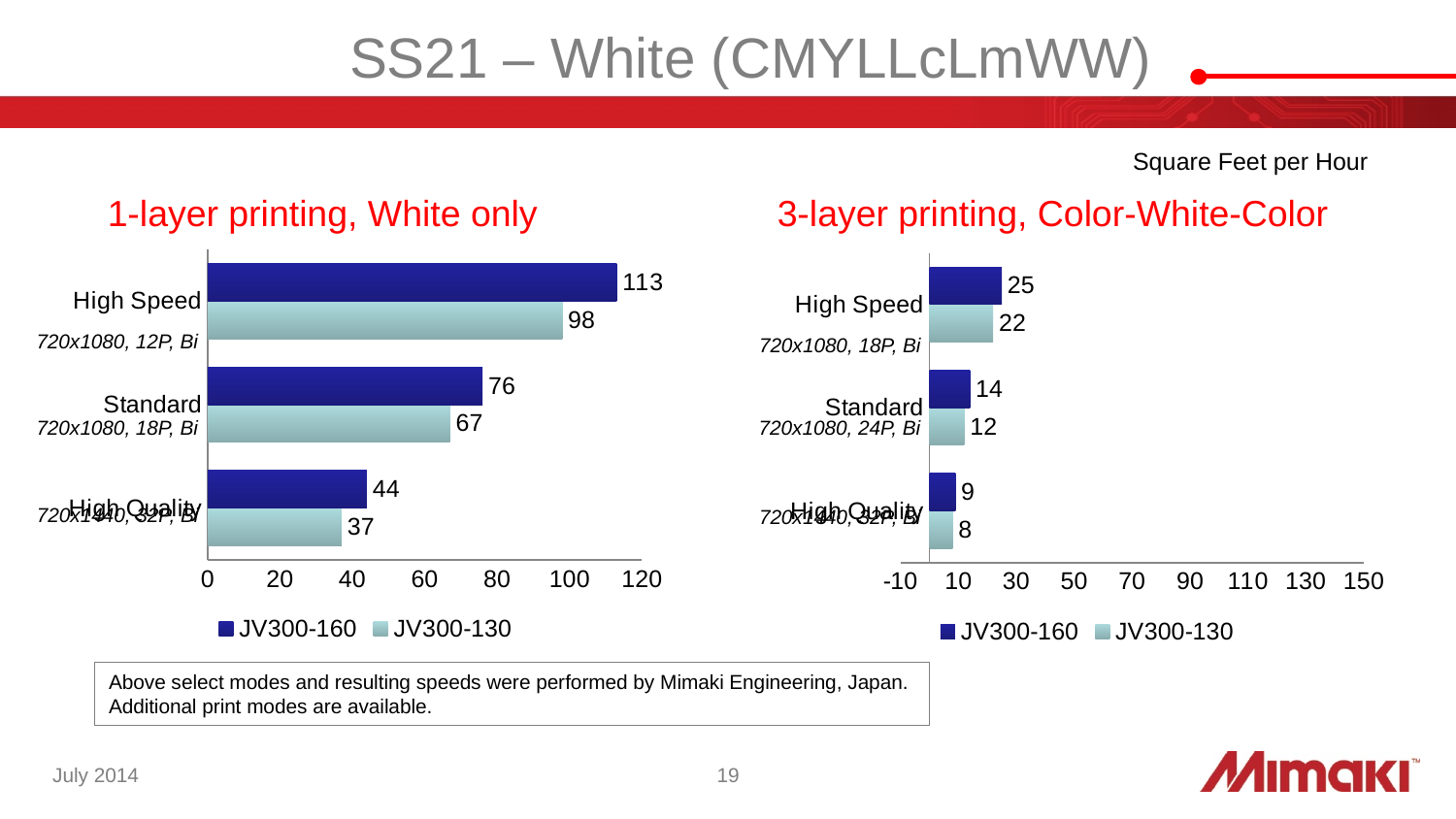
What kind of chart is the '1-layer printing, White only' chart? Bar chart In the '1-layer printing, White only' chart, what is the value for JV300-130 at Standard? 67 In the '3-layer printing, Color-White-Color' chart, what is the value for JV300-130 at High Quality? 8 In the '3-layer printing, Color-White-Color' chart, what is the value for JV300-160 at Standard? 14 In the '3-layer printing, Color-White-Color' chart, which category has the lowest JV300-130 value? High Quality In the '1-layer printing, White only' chart, what is the difference between the JV300-160 and JV300-130 values at High Speed? 15 In the '1-layer printing, White only' chart, what is the value for JV300-160 at High Speed? 113 How many categories are shown in the '3-layer printing, Color-White-Color' chart? 3 How many series does the legend of the '1-layer printing, White only' chart list? 2 In the '1-layer printing, White only' chart, which is larger at High Quality: JV300-160 or JV300-130? JV300-160 In the '3-layer printing, Color-White-Color' chart, what is the difference between the JV300-160 and JV300-130 values at High Speed? 3 In the '1-layer printing, White only' chart, which category has the highest JV300-160 value? High Speed